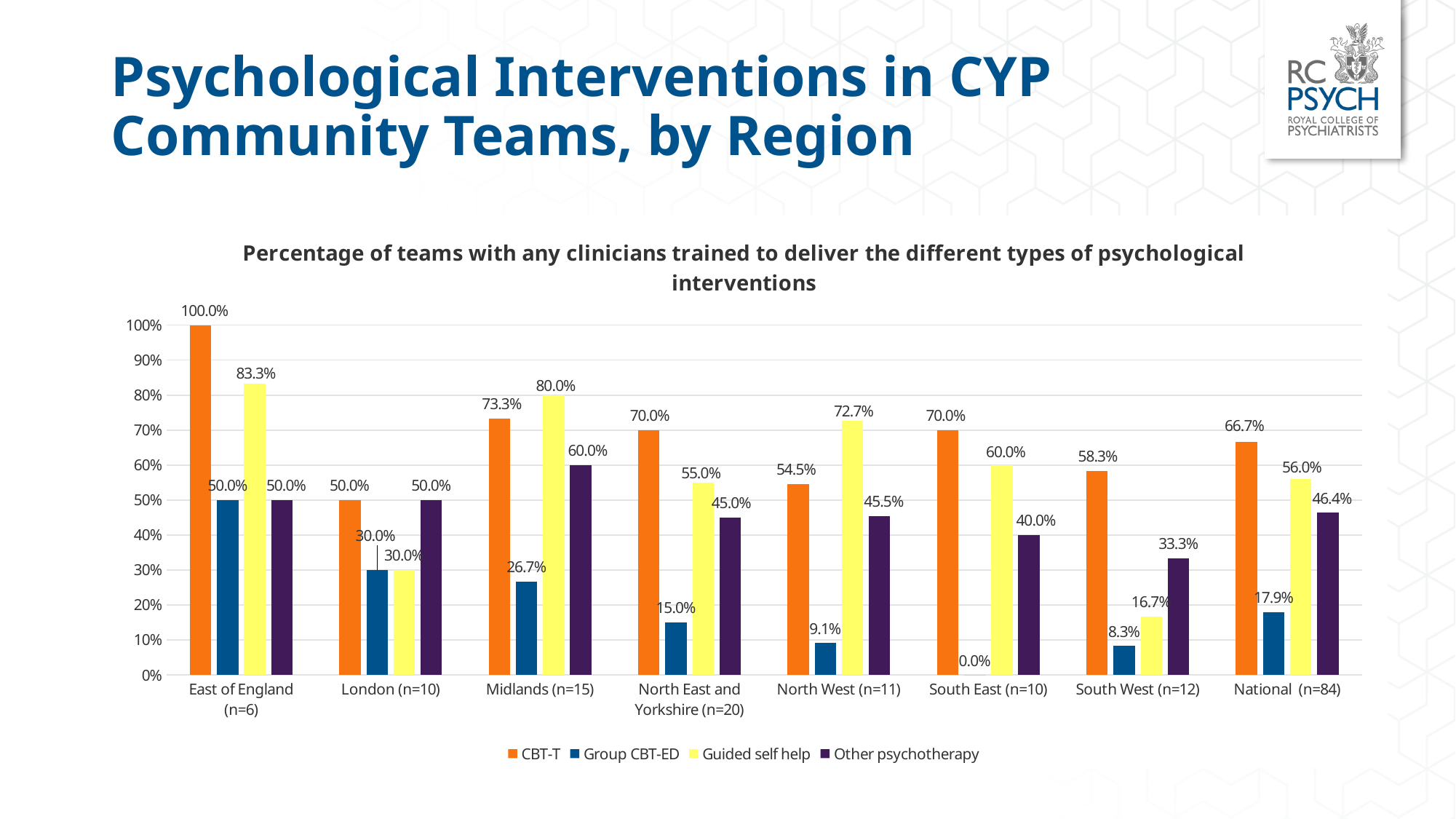
What is the Other psychotherapy value for National (n=84)? 46.4% What type of chart is shown on the slide? Bar chart Which series is shown in yellow in the legend? Guided self help What is the difference between the CBT-T and Group CBT-ED values for National (n=84)? 48.8% How many region categories are shown on the x axis? 8 What is the CBT-T value for East of England (n=6)? 100.0% What is the Group CBT-ED value for South East (n=10)? 0.0% Which region has the lowest Guided self help value? South West (n=12) Which region has the highest CBT-T value? East of England (n=6) What is the Guided self help value for Midlands (n=15)? 80.0% Which is larger for North West (n=11): the CBT-T value or the Guided self help value? Guided self help How many series does the legend list? 4